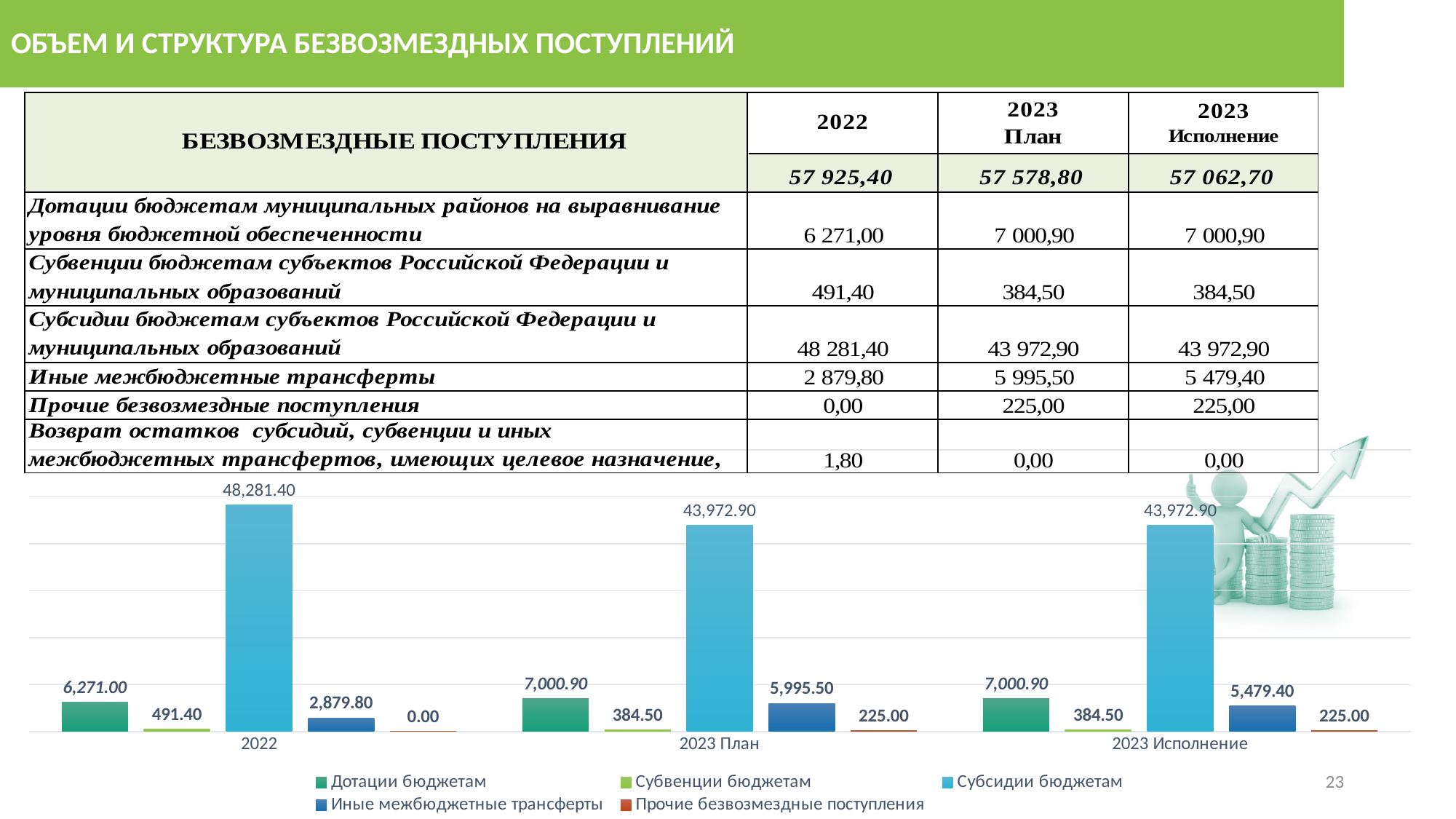
Which series has the lowest value in 2023 План on the bar chart? Прочие безвозмездные поступления Which series has the highest value in 2022 on the bar chart? Субсидии бюджетам On the bar chart, what is the difference between Иные межбюджетные трансферты in 2023 План and in 2023 Исполнение? 516.10 On the bar chart, is Дотации бюджетам larger in 2022 or in 2023 План? 2023 План What is the value for Субсидии бюджетам in 2022 on the bar chart? 48,281.40 How many categories are shown on the x axis of the bar chart? 3 How many series does the legend of the bar chart list? 5 What kind of chart is shown at the bottom of the slide? Bar chart On the bar chart, what is the difference between Субсидии бюджетам in 2022 and in 2023 План? 4,308.50 What is the value for Дотации бюджетам in 2023 Исполнение on the bar chart? 7,000.90 What is the value for Иные межбюджетные трансферты in 2023 План on the bar chart? 5,995.50 What is the value for Прочие безвозмездные поступления in 2022 on the bar chart? 0.00